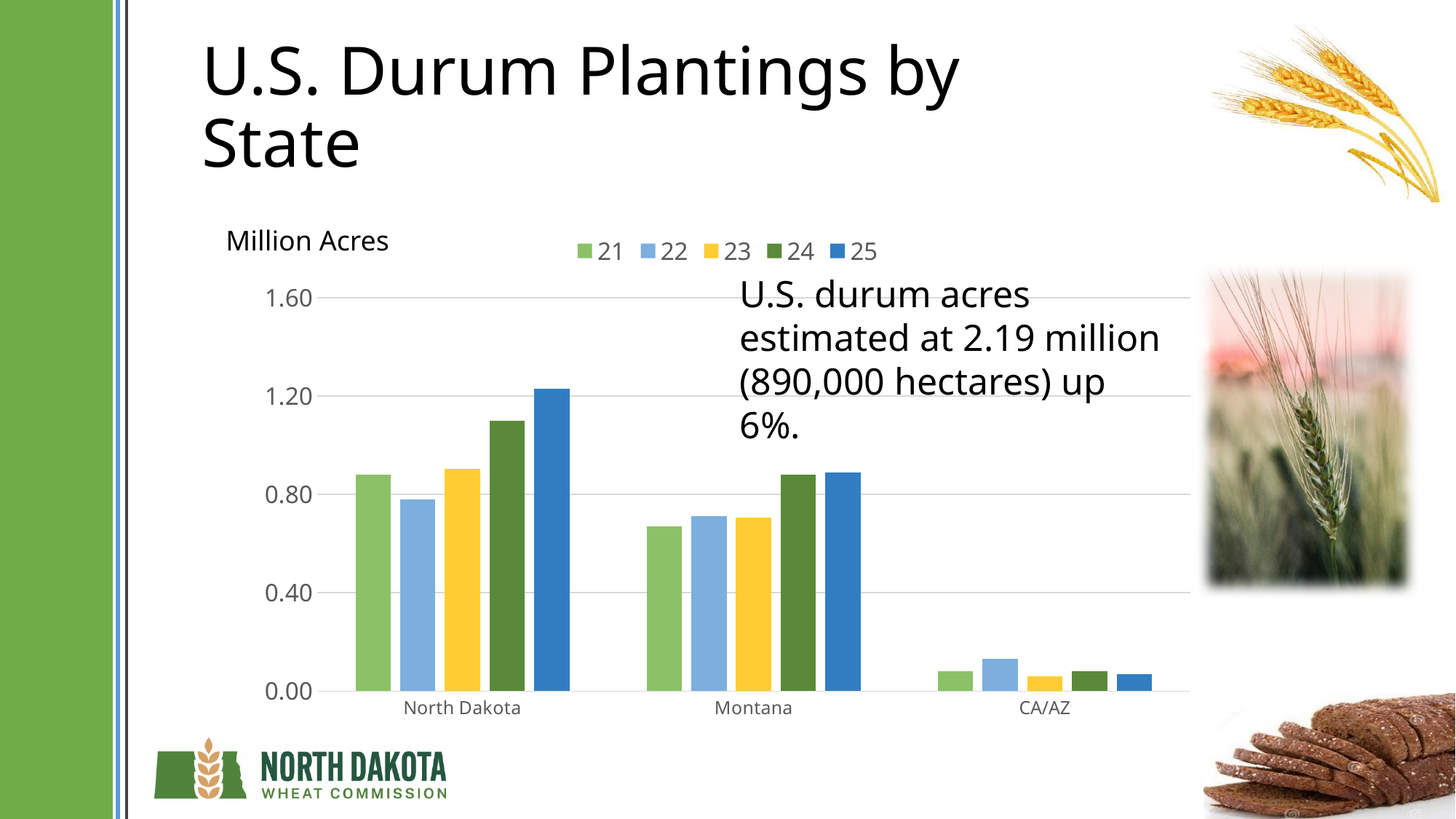
How many states or regions are shown on the x axis of the chart? 3 Which state or region has the lowest durum plantings for series 24? CA/AZ Is the value for CA/AZ in series 22 greater or less than 0.40? less Is the value for North Dakota in series 24 greater or less than 1.20? less What unit is the y axis of the chart measured in? Million Acres Is the value for Montana in series 21 greater or less than 0.80? less Which state or region has the highest durum plantings for series 25? North Dakota Which is larger, the series 25 value for North Dakota or the series 25 value for Montana? North Dakota Which legend entry is shown in yellow? 23 What kind of chart is shown on the slide? bar chart How many series does the chart legend list? 5